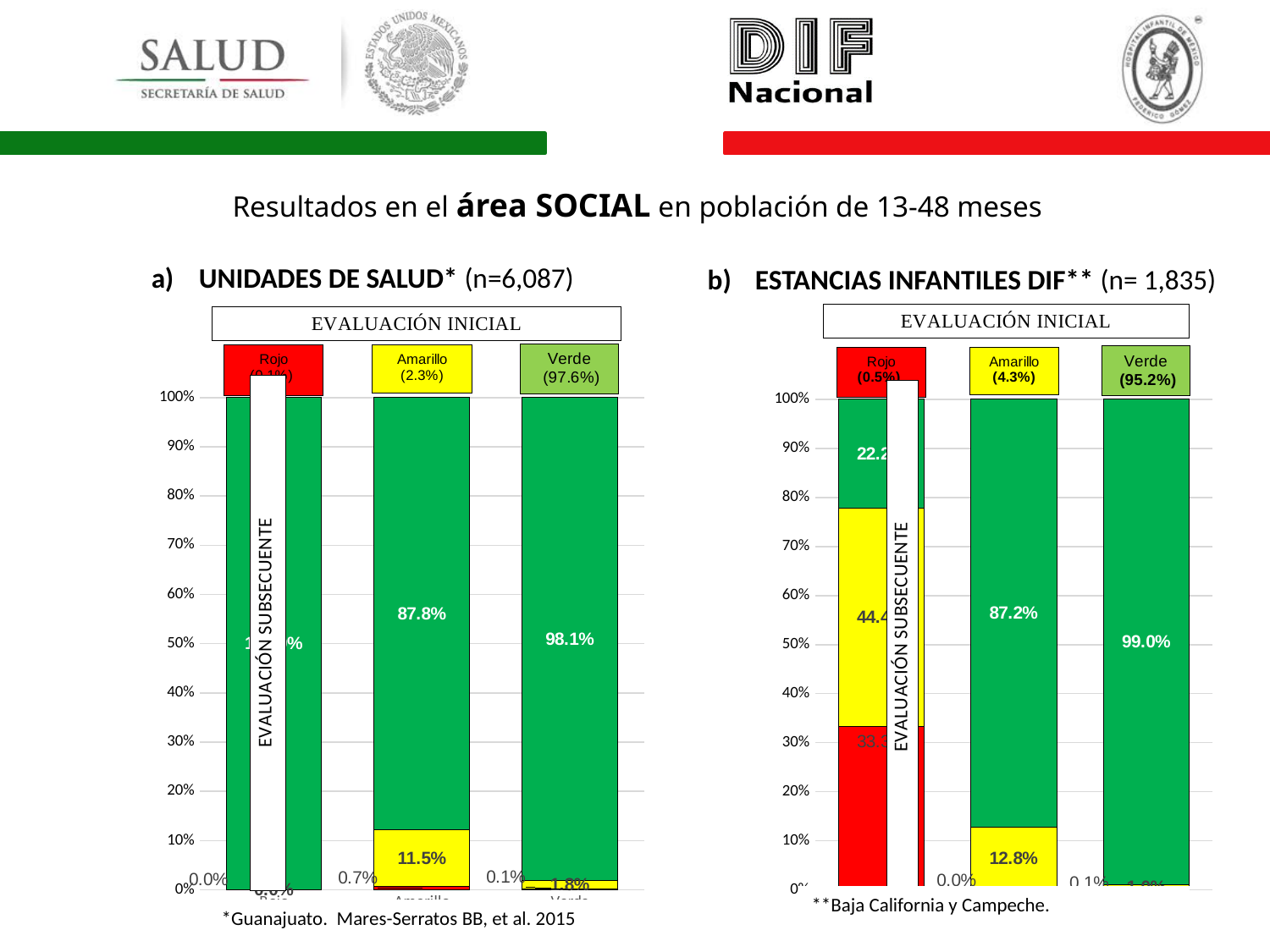
In chart b) ESTANCIAS INFANTILES DIF, what is the difference between the green segment of the Verde bar and the green segment of the Amarillo bar? 11.8 percentage points In chart a) UNIDADES DE SALUD, what initial-evaluation percentage is shown in the Verde header label? 97.6% In chart a) UNIDADES DE SALUD, what percentage of the Amarillo bar is the yellow segment? 11.5% In chart a) UNIDADES DE SALUD, which bar has the larger green segment, Amarillo or Verde? Verde In chart a) UNIDADES DE SALUD, what percentage of the Verde bar is the green segment? 98.1% In chart b) ESTANCIAS INFANTILES DIF, what percentage of the Amarillo bar is the yellow segment? 12.8% How many bars (initial-evaluation categories) are shown in chart b) ESTANCIAS INFANTILES DIF? 3 In chart b) ESTANCIAS INFANTILES DIF, what percentage of the Amarillo bar is the green segment? 87.2% What type of chart is used in chart a) UNIDADES DE SALUD? Stacked bar chart In chart a) UNIDADES DE SALUD, what percentage of the Amarillo bar is the green segment? 87.8% In chart b) ESTANCIAS INFANTILES DIF, what initial-evaluation percentage is shown in the Amarillo header label? 4.3% In chart b) ESTANCIAS INFANTILES DIF, what percentage of the Verde bar is the green segment? 99.0%